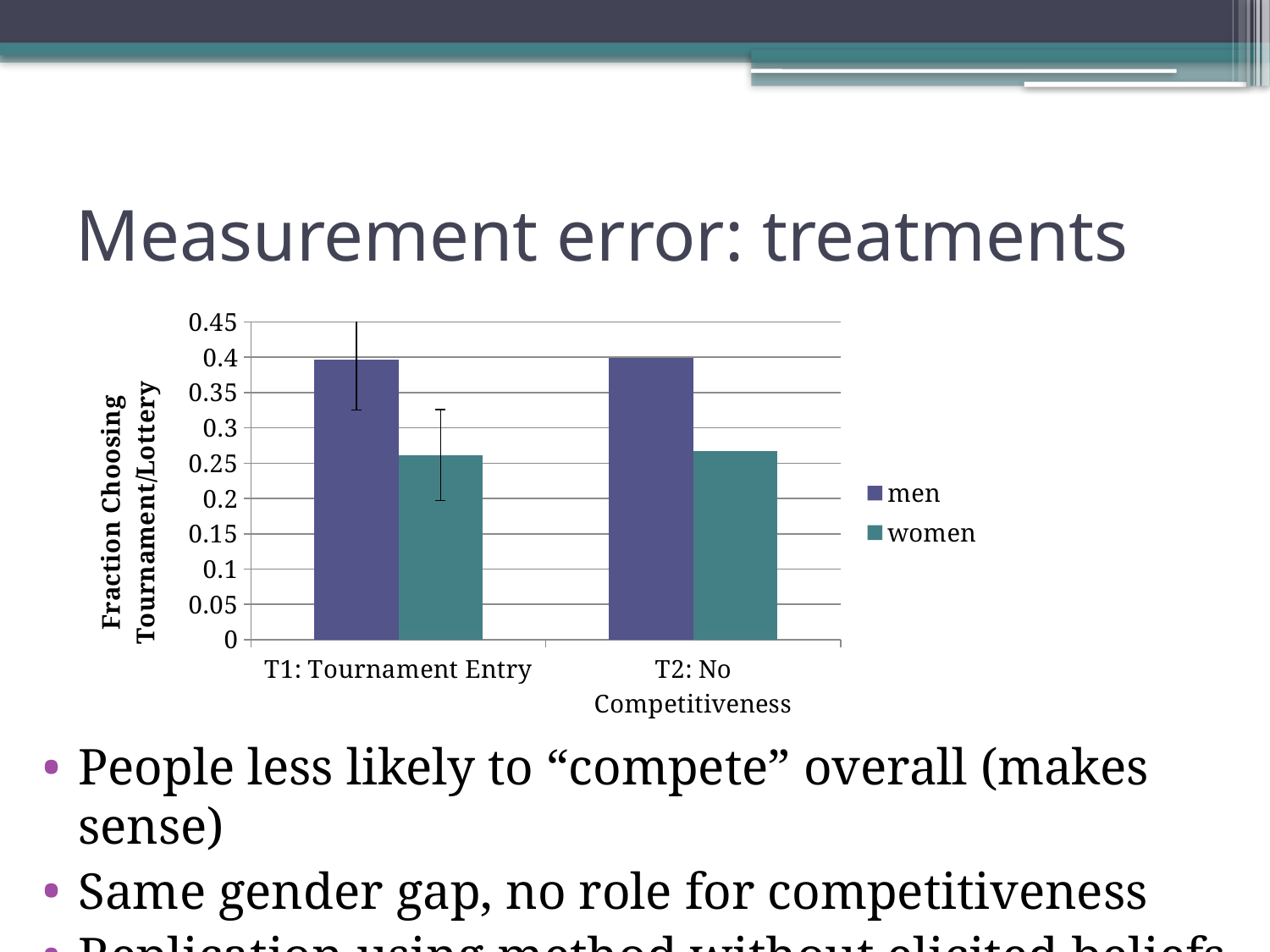
Is the value for women in T2: No Competitiveness greater or less than 0.3? less What are the two entries in the legend? men, women Is the value for women in T1: Tournament Entry greater or less than 0.2? greater How many treatment categories are shown on the x axis? 2 What is the label of the y axis? Fraction Choosing Tournament/Lottery In T1: Tournament Entry, which is larger, the value for men or for women? men Is the value for men in T2: No Competitiveness greater or less than 0.3? greater How many series does the legend list? 2 What kind of chart is shown on the slide? bar chart In T2: No Competitiveness, which is larger, the value for men or for women? men